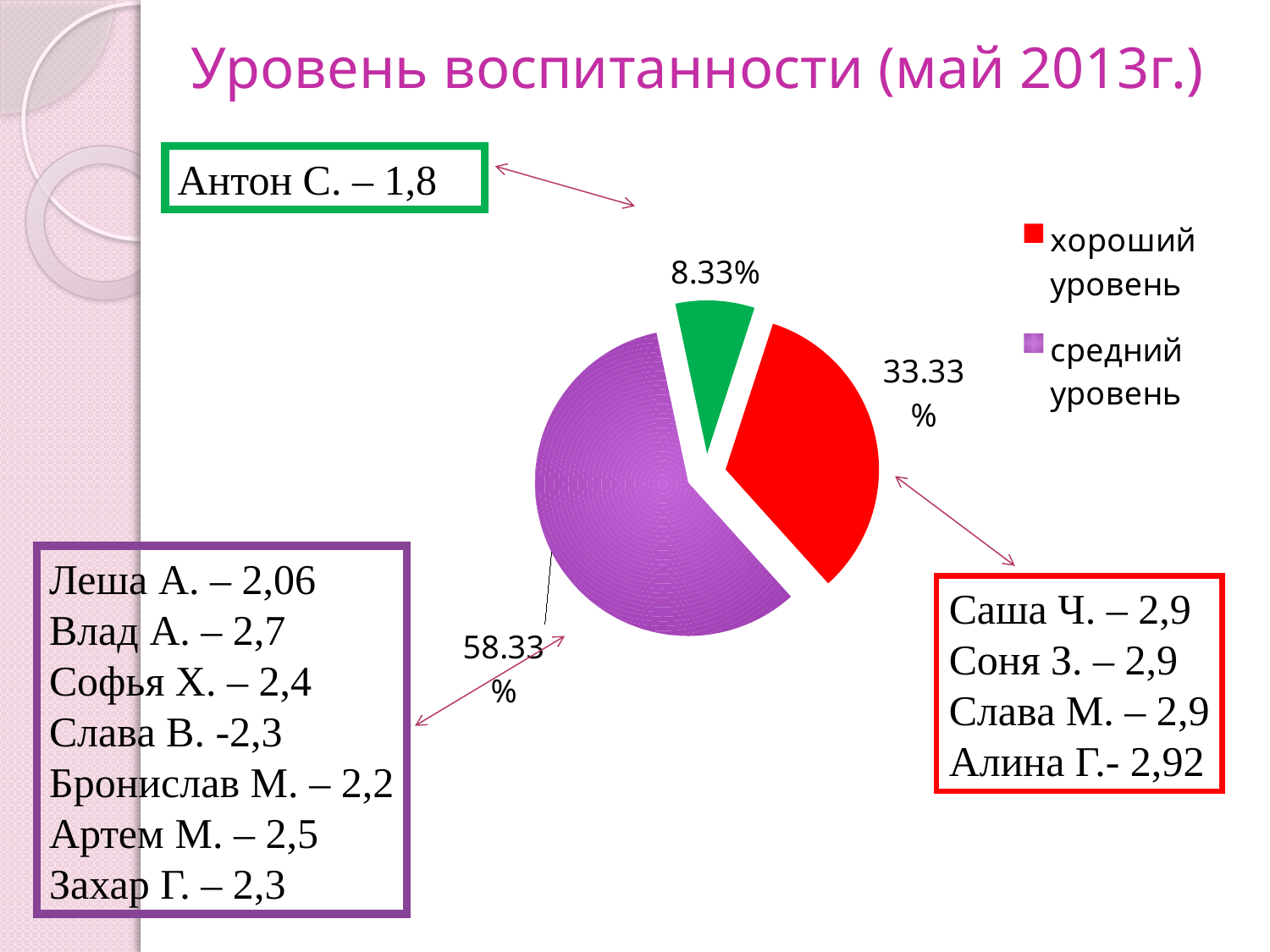
Which is larger: the share for "хороший уровень" or the share for "средний уровень"? средний уровень What colour is the "хороший уровень" slice? red What share of the pie does "средний уровень" take? 58.33% What share of the pie does the green slice take? 8.33% What is the title of the slide with the pie chart? Уровень воспитанности (май 2013г.) Which slice of the pie is the largest? средний уровень What kind of chart is shown on the slide? pie chart How many slices does the pie chart have? 3 What share of the pie does "хороший уровень" take? 33.33% How many entries does the legend list? 2 By how many percentage points does the "средний уровень" share exceed the "хороший уровень" share? 25 Which slice of the pie is the smallest? the green slice (8.33%)